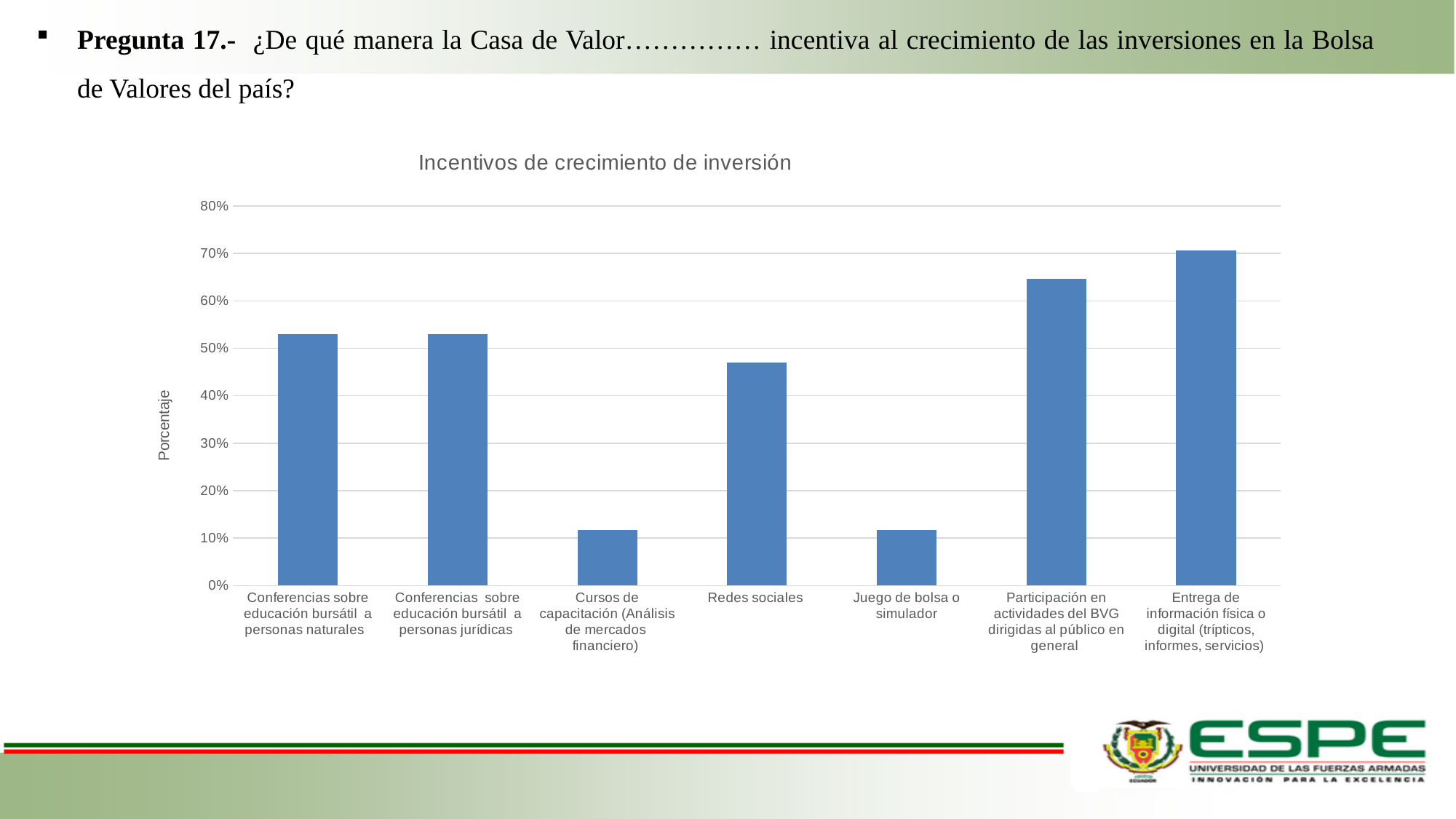
Is the value for Conferencias sobre educación bursátil a personas naturales greater or less than 40%? greater Which category has the highest bar in the chart? Entrega de información física o digital (trípticos, informes, servicios) How many categories are shown on the x axis of the chart? 7 Is the value for Cursos de capacitación (Análisis de mercados financiero) greater or less than 20%? less What is the label of the vertical axis? Porcentaje Is the value for Juego de bolsa o simulador greater or less than 20%? less What kind of chart is shown on the slide? Bar chart Which is larger: the value for Redes sociales or the value for Cursos de capacitación (Análisis de mercados financiero)? Redes sociales Which is larger: the value for Conferencias sobre educación bursátil a personas jurídicas or the value for Redes sociales? Conferencias sobre educación bursátil a personas jurídicas What is the title of the chart? Incentivos de crecimiento de inversión